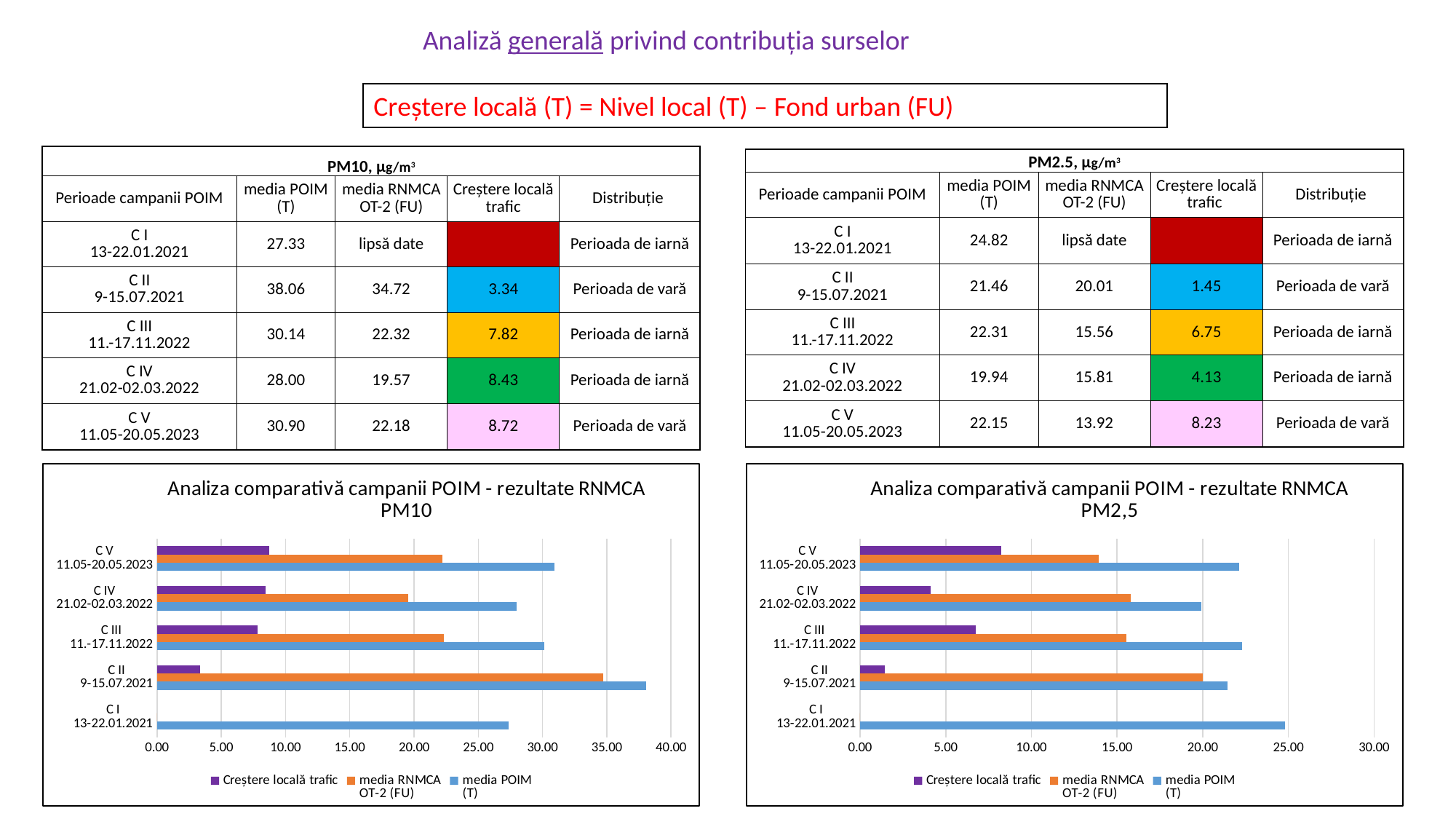
How many series does the legend of the PM2,5 chart list? 3 What kind of chart is the 'Analiza comparativă campanii POIM - rezultate RNMCA PM10' chart? bar chart In the PM10 chart, is the 'media POIM (T)' value for C I 13-22.01.2021 greater or less than 30.00? less In the PM10 chart, which campaign has the lowest 'Creștere locală trafic' value? C II 9-15.07.2021 In the PM2,5 chart, is the 'media RNMCA OT-2 (FU)' value for C V 11.05-20.05.2023 greater or less than 15.00? less In the PM10 chart, which colour represents the 'Creștere locală trafic' series? purple In the PM2,5 chart, which campaign has the highest 'Creștere locală trafic' value? C V 11.05-20.05.2023 In the PM10 chart, is the 'media POIM (T)' value for C II 9-15.07.2021 greater or less than 35.00? greater In the PM10 chart, which campaign has the highest 'media POIM (T)' value? C II 9-15.07.2021 In the PM2,5 chart, which campaign has the highest 'media POIM (T)' value? C I 13-22.01.2021 How many campaign categories are shown on the y axis of the PM10 chart? 5 In the PM10 chart, which is larger: the 'media RNMCA OT-2 (FU)' value for C III 11.-17.11.2022 or for C IV 21.02-02.03.2022? C III 11.-17.11.2022